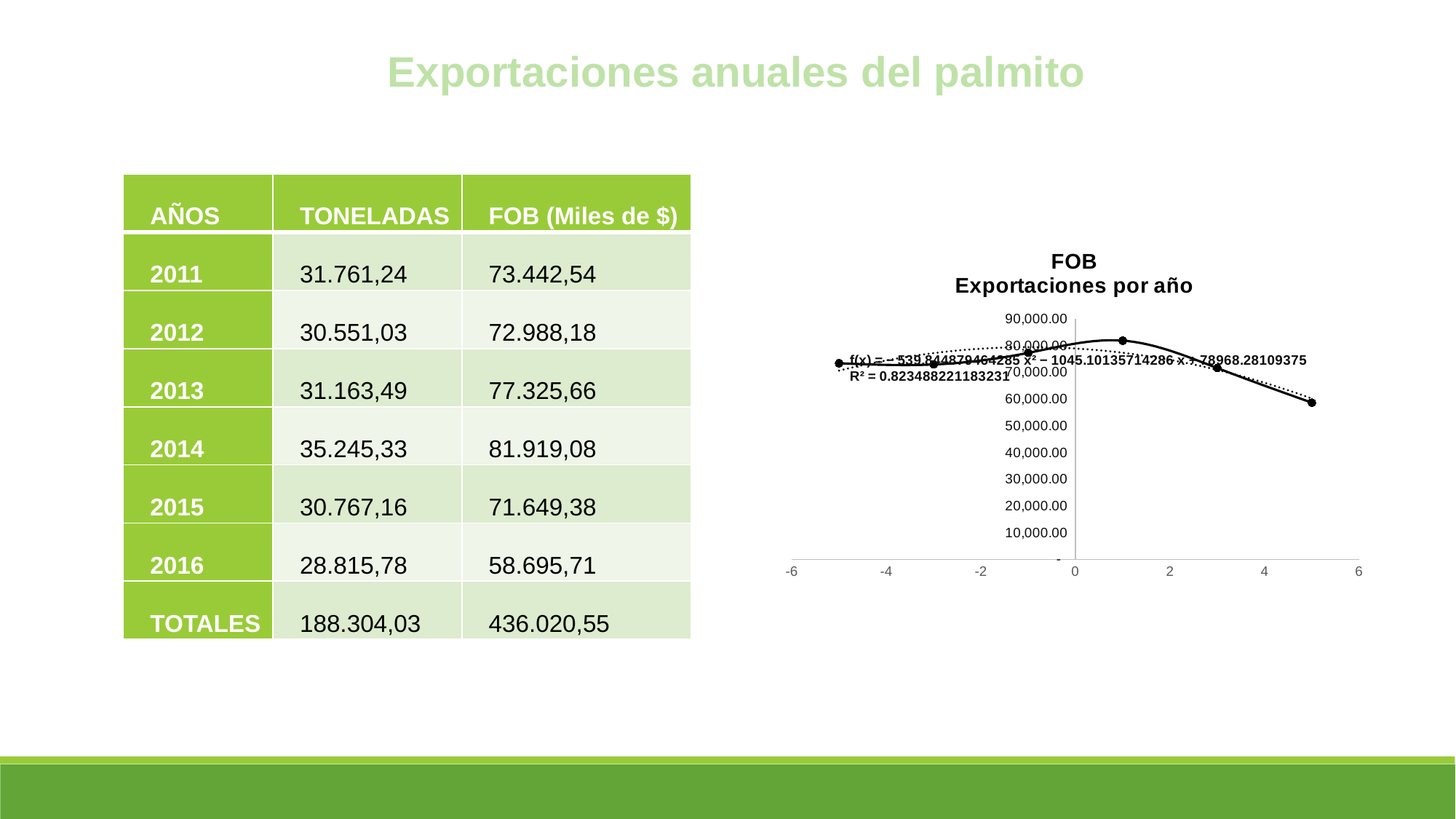
What kind of chart is the 'FOB Exportaciones por año' chart? scatter chart with a line How many data points are plotted in the 'FOB Exportaciones por año' chart? 6 In the 'FOB Exportaciones por año' chart, at which x value is the plotted point highest? 1 In the 'FOB Exportaciones por año' chart, do the values rise or fall between x = 1 and x = 5? fall What is the title of the chart on the right side of the slide? FOB Exportaciones por año What is the highest tick label on the y axis of the 'FOB Exportaciones por año' chart? 90,000.00 In the 'FOB Exportaciones por año' chart, is the value at x = 5 greater or less than 70,000.00? less In the 'FOB Exportaciones por año' chart, is the value at x = 1 greater or less than 70,000.00? greater In the 'FOB Exportaciones por año' chart, which point is higher: the one at x = 1 or the one at x = 5? x = 1 In the 'FOB Exportaciones por año' chart, is the value at x = 3 greater or less than 60,000.00? greater What R² value is printed on the 'FOB Exportaciones por año' chart? R² = 0.823488221183231 In the 'FOB Exportaciones por año' chart, at which x value is the plotted point lowest? 5